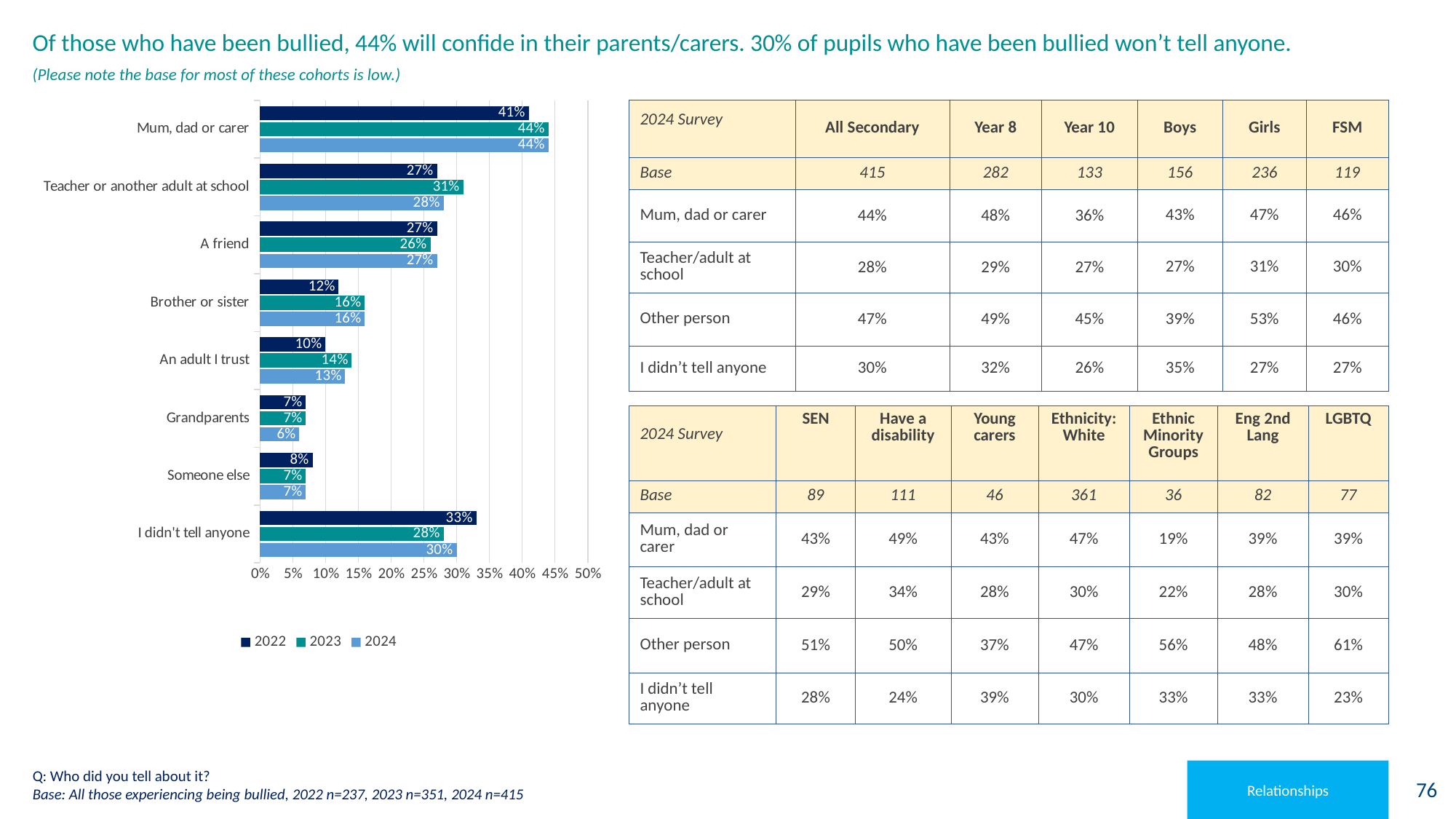
What is the difference between the 2022 and 2024 values for 'I didn't tell anyone' in the bar chart? 3% How many series does the legend of the bar chart list? 3 What kind of chart is shown on the left of the slide? bar chart Which category has the highest 2024 value in the bar chart? Mum, dad or carer Which category has the lowest 2024 value in the bar chart? Grandparents What is the 2024 value for 'Mum, dad or carer' in the bar chart? 44% Which series in the bar chart is shown in the darkest blue colour? 2022 How many categories are shown in the bar chart? 8 What is the 2022 value for 'I didn't tell anyone' in the bar chart? 33% In the bar chart, is the 2023 value for 'Brother or sister' larger or smaller than the 2023 value for 'An adult I trust'? larger What is the 2024 value for 'Grandparents' in the bar chart? 6% What is the 2023 value for 'Teacher or another adult at school' in the bar chart? 31%